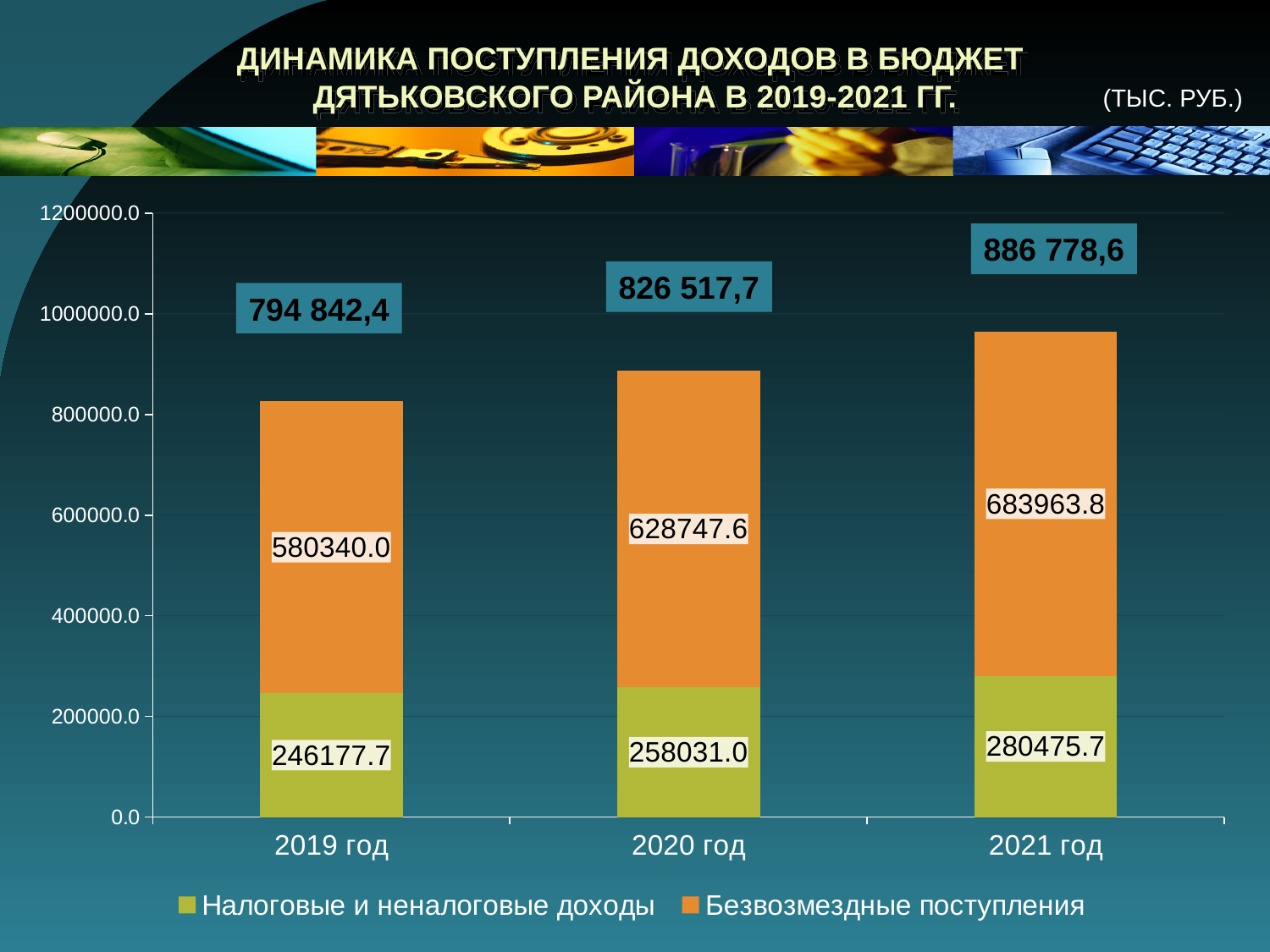
What is the value of Безвозмездные поступления for 2021 год? 683963.8 What is the value of Налоговые и неналоговые доходы for 2019 год? 246177.7 How many series does the legend list? 2 Do the values for Безвозмездные поступления rise or fall from 2019 год to 2021 год? rise What total value is printed in the box above the 2021 год bar? 886 778,6 What type of chart is shown on the slide? stacked bar chart What is the value of Безвозмездные поступления for 2020 год? 628747.6 What is the difference between Налоговые и неналоговые доходы in 2021 год and 2020 год? 22444.7 Which year has the lowest value for Налоговые и неналоговые доходы? 2019 год What is the value of Налоговые и неналоговые доходы for 2021 год? 280475.7 How many years (categories) are shown on the x axis? 3 Which year has the highest value for Безвозмездные поступления? 2021 год